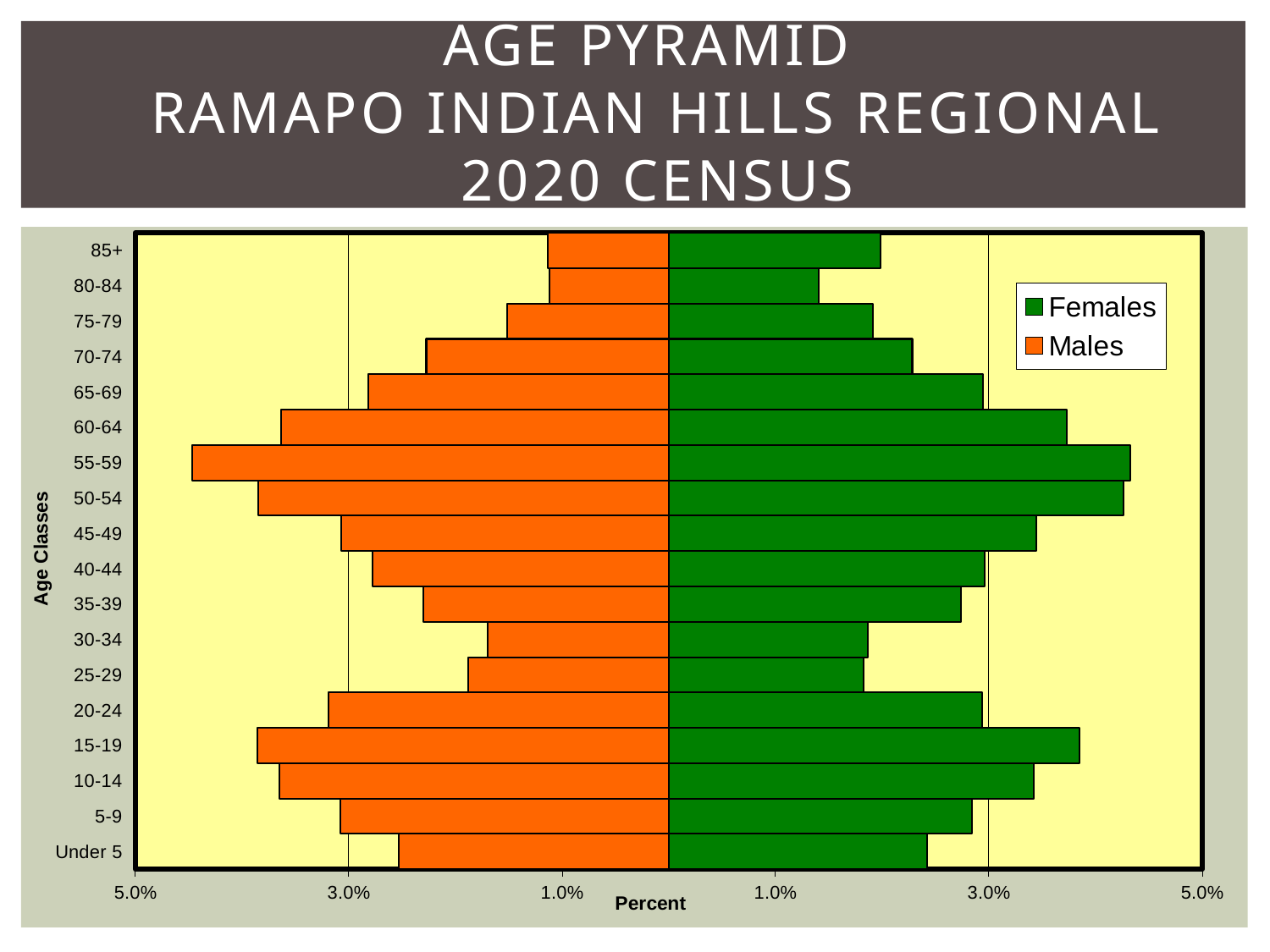
How many age classes are shown on the vertical axis? 18 Is the value for Males in the 55-59 age class greater or less than 3.0%? greater Which age class has the highest value for Males? 55-59 Which age class has the lowest value for Females? 80-84 For Females, which is larger: the 60-64 age class or the 65-69 age class? 60-64 For Males, which is larger: the 15-19 age class or the 20-24 age class? 15-19 Is the value for Females in the 15-19 age class greater or less than 3.0%? greater What kind of chart is shown on the slide? bar chart Is the value for Females in the 85+ age class greater or less than 3.0%? less How many series does the legend list? 2 What colour represents Females in the chart? green